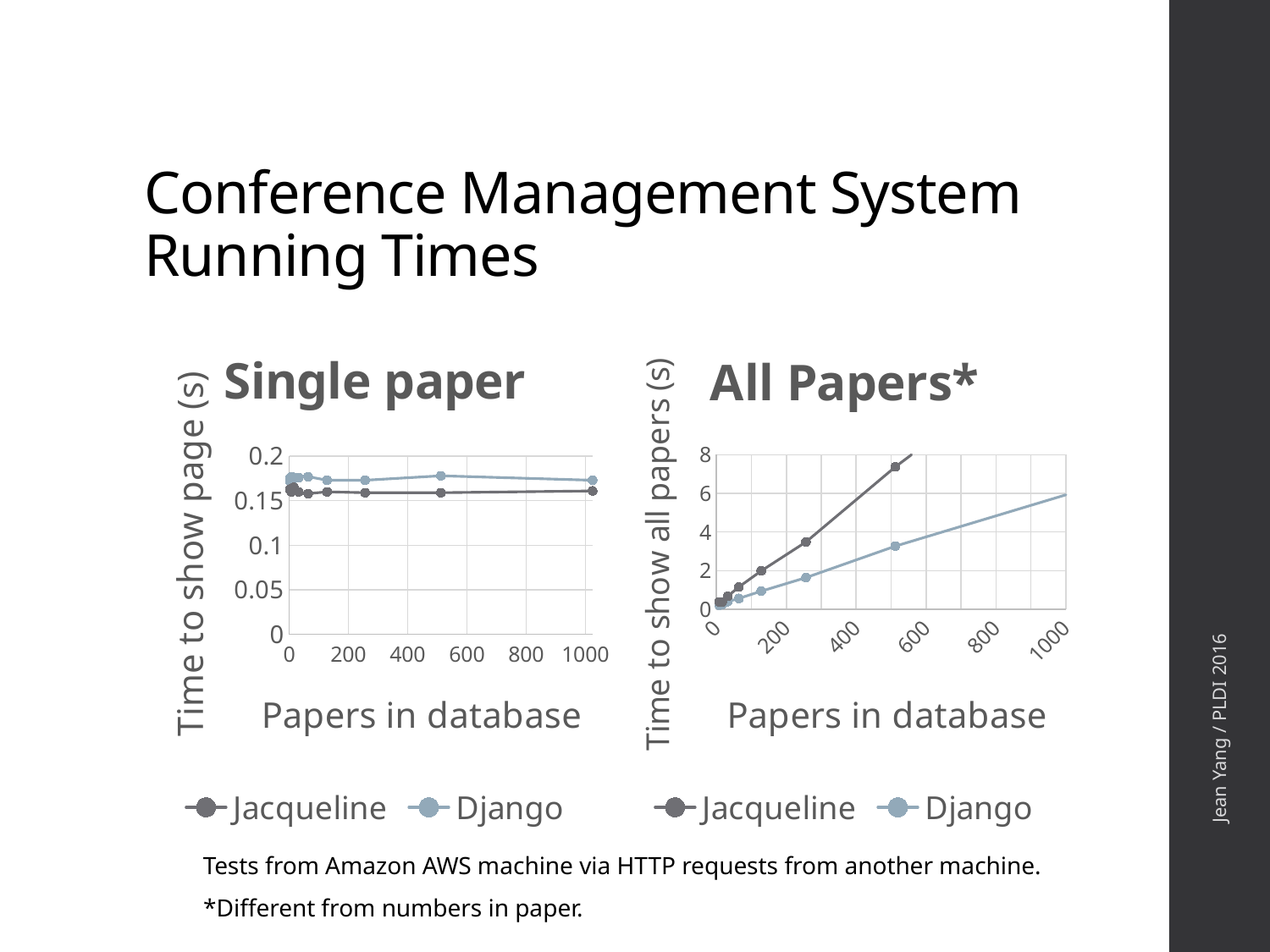
In the "All Papers*" chart, is the value for Jacqueline at 500 papers greater or less than 6? greater What is the x-axis label of the "All Papers*" chart? Papers in database What kind of chart is the "Single paper" chart? line chart In the "Single paper" chart, is the value for Django at 1000 papers greater or less than 0.2? less In the "All Papers*" chart, is the value for Django at 500 papers greater or less than 2? greater How many series does the legend of the "All Papers*" chart list? 2 In the "All Papers*" chart, which series has the larger value at 500 papers, Jacqueline or Django? Jacqueline What kind of chart is the "All Papers*" chart? line chart In the "Single paper" chart, what are the two series named in the legend? Jacqueline and Django In the "All Papers*" chart, do the values for Jacqueline rise or fall as the number of papers in the database increases? rise